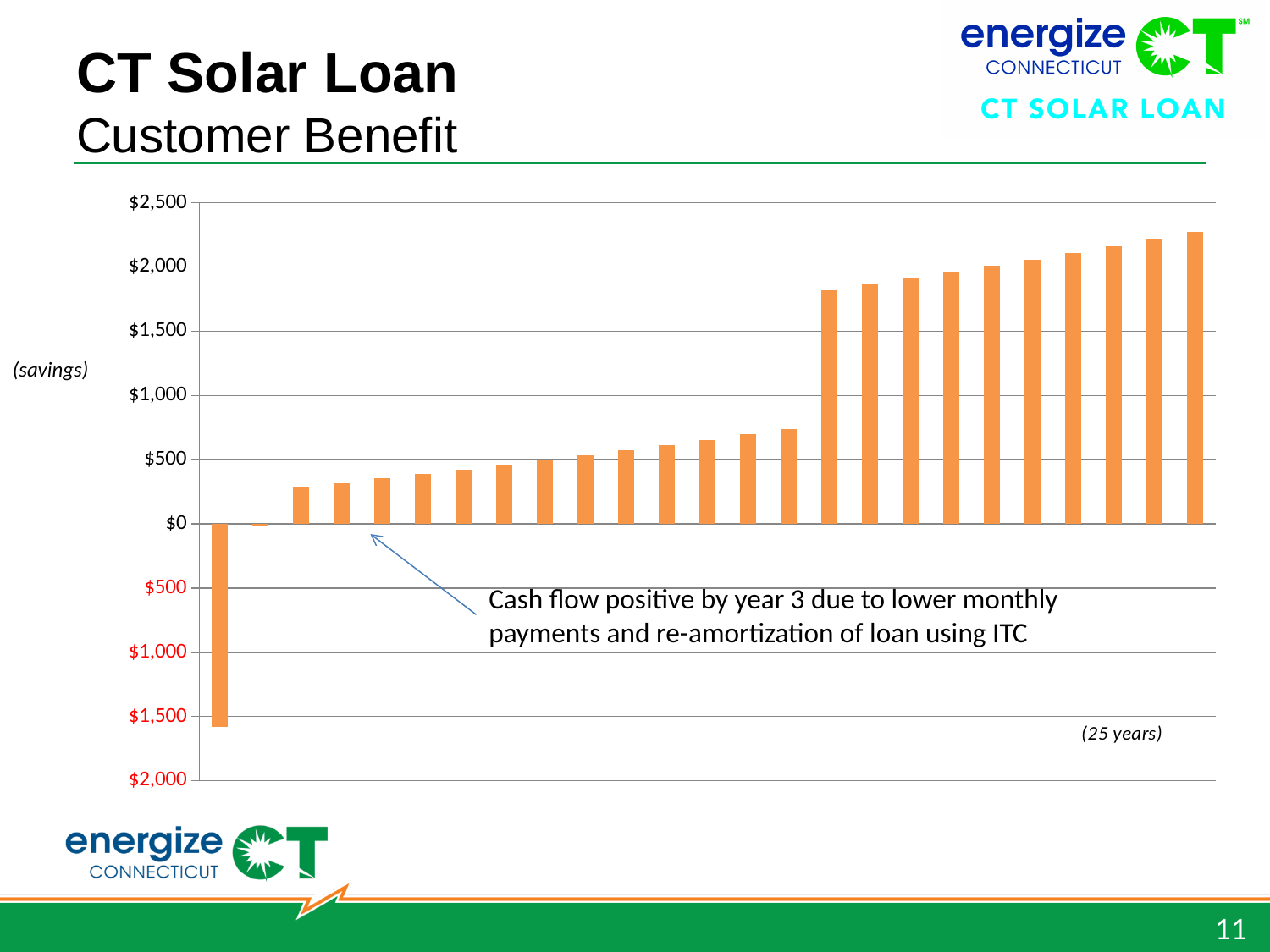
Is the value of the leftmost bar greater or less than -$1,500? less How many bars exceed $1,500? 10 Which is larger, the value of the leftmost bar or the value of the rightmost bar? the rightmost bar What kind of chart is shown on the slide? bar chart Which bar has the lowest value in the chart? the leftmost (first) bar Do the bar values generally rise or fall from left to right across the chart? rise What time span does the note at the bottom right of the chart indicate? (25 years) Is the value of the tallest bar in the left group (the bar just before the large jump) greater or less than $1,000? less Is the value of the rightmost bar greater or less than $2,000? greater What label is written next to the vertical axis of the chart? (savings) How many bars are plotted in the chart? 25 Which bar has the highest value in the chart? the rightmost (last) bar